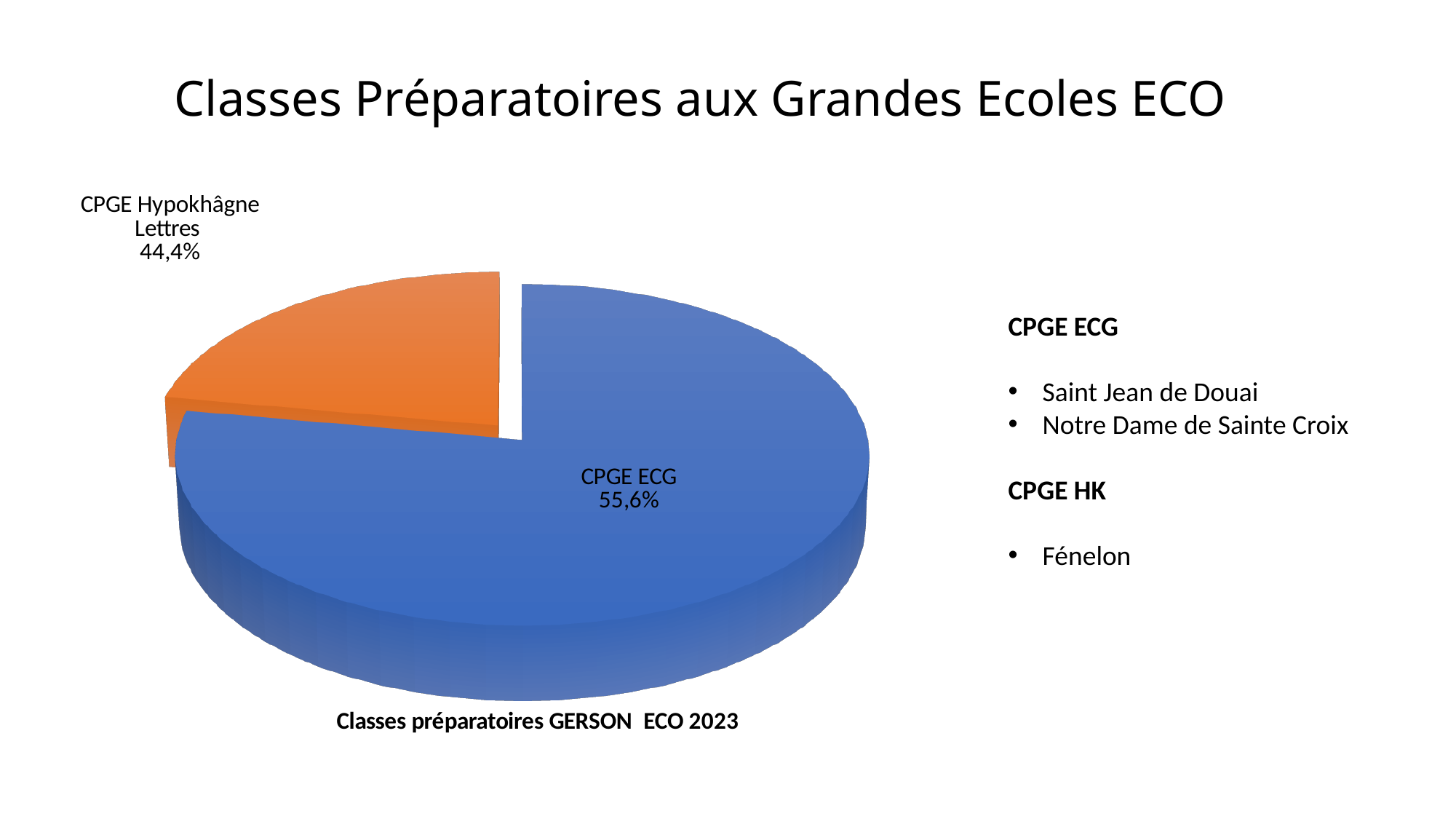
What is the title printed below the pie chart? Classes préparatoires GERSON ECO 2023 Which is larger, the share for CPGE ECG or the share for CPGE Hypokhâgne Lettres? CPGE ECG How many slices does the pie chart have? 2 Is the share for CPGE ECG greater or less than 50%? greater Which slice of the pie is the largest? CPGE ECG What is the difference in percentage points between the CPGE ECG share and the CPGE Hypokhâgne Lettres share? 11,2 Which slice of the pie is the smallest? CPGE Hypokhâgne Lettres What share of the pie does CPGE ECG represent? 55,6% What colour is the CPGE Hypokhâgne Lettres slice? Orange What share of the pie does CPGE Hypokhâgne Lettres represent? 44,4% What kind of chart is shown on the slide? Pie chart